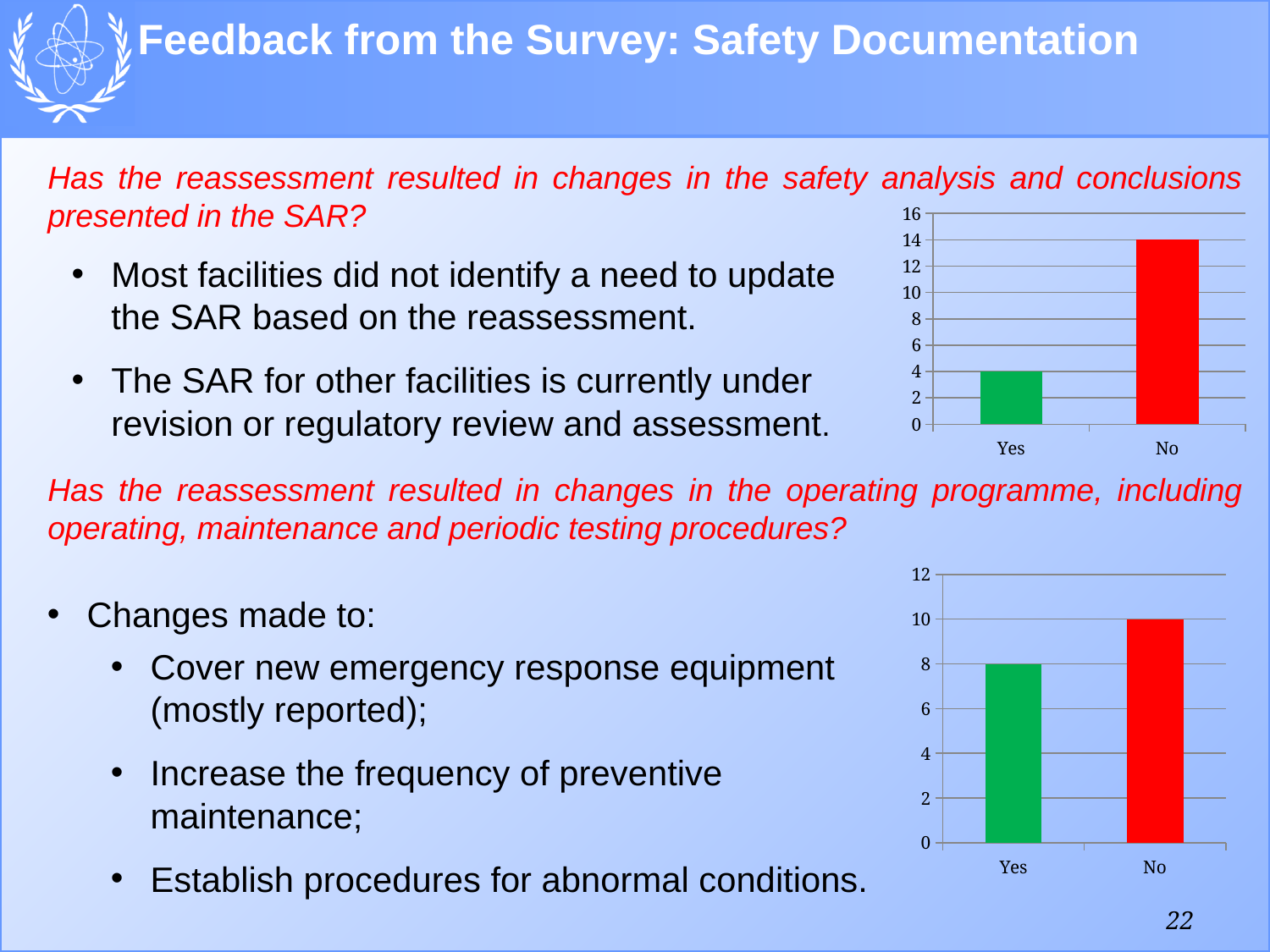
In the bottom chart, what is the value for Yes? 8 In the top chart, what is the value for No? 14 In the bottom chart, what is the value for No? 10 In the top chart, which category has the highest value? No How many categories are shown in the top chart? 2 In the bottom chart, what is the difference between the values for No and Yes? 2 What type of chart is the bottom chart? Bar chart In the top chart, is the value for No greater or less than 10? greater In the top chart, what is the difference between the values for No and Yes? 10 In the bottom chart, is the value for Yes greater or less than 6? greater In the bottom chart, which category has the lowest value? Yes In the top chart, what is the value for Yes? 4